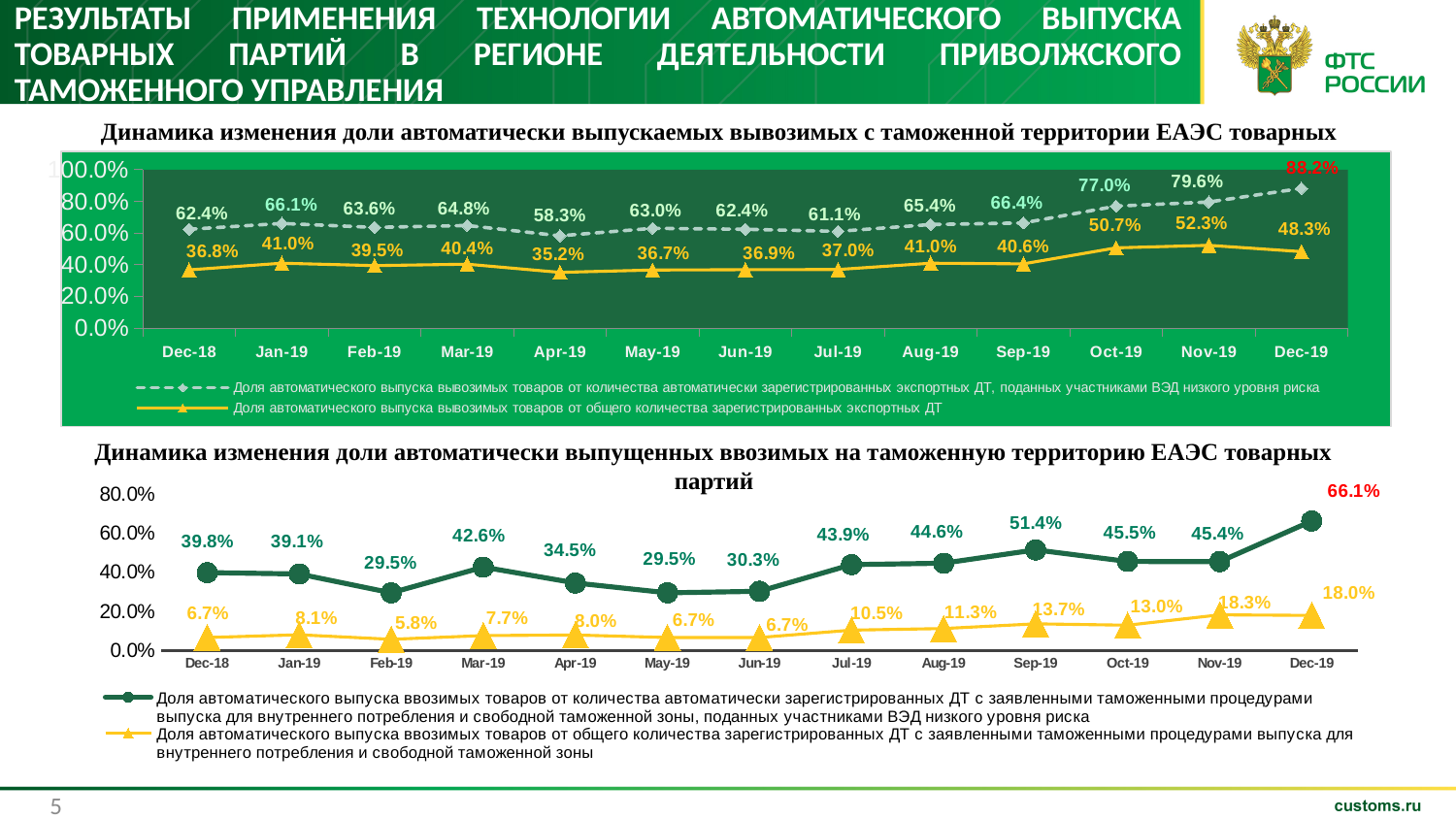
How many months are plotted on the x axis of the top chart? 13 In the bottom chart, which is larger: the dark green line's value for Mar-19 or for Apr-19? Mar-19 What type of chart is the bottom chart? Line chart In the bottom chart, what is the value of the dark green line for Sep-19? 51.4% In the bottom chart, which month has the lowest value for the yellow triangle-marker series? Feb-19 In the top chart, which month has the lowest value for the dashed diamond-marker series? Apr-19 In the top chart, what is the difference between the dashed diamond-marker series and the yellow triangle-marker series in Nov-19? 27.3% In the top chart, which month has the highest value for the yellow triangle-marker series? Nov-19 In the bottom chart, is the dark green line's value for Dec-19 greater or less than 60.0%? greater In the bottom chart, what is the value of the yellow triangle-marker series for Dec-19? 18.0% In the top chart, what is the value of the dashed diamond-marker series for Apr-19? 58.3% In the top chart, what is the value of the yellow triangle-marker series for Oct-19? 50.7%